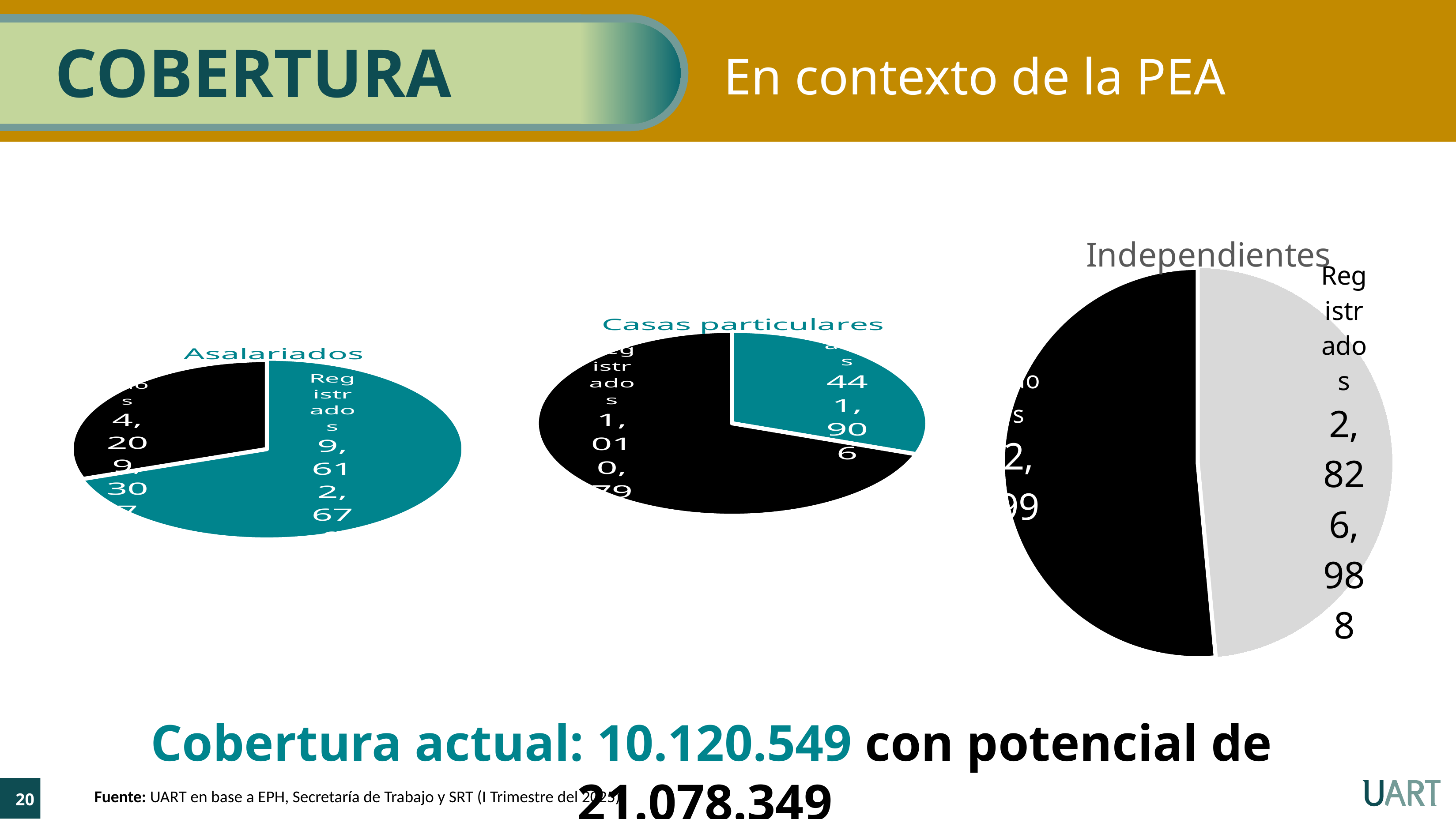
What are the titles of the three pie charts on the slide? Asalariados, Casas particulares, Independientes How many slices does the Casas particulares pie chart have? 2 How many slices does the Independientes pie chart have? 2 In the Asalariados chart, which slice is larger, Registrados or the other slice? Registrados What kind of chart is the Asalariados chart? pie chart In the Casas particulares chart, which slice is the largest? No Registrados In the Independientes chart, what is the value for Registrados? 2,826,988 In the Independientes chart, what colour is the Registrados slice? grey How many pie charts are shown on the slide? 3